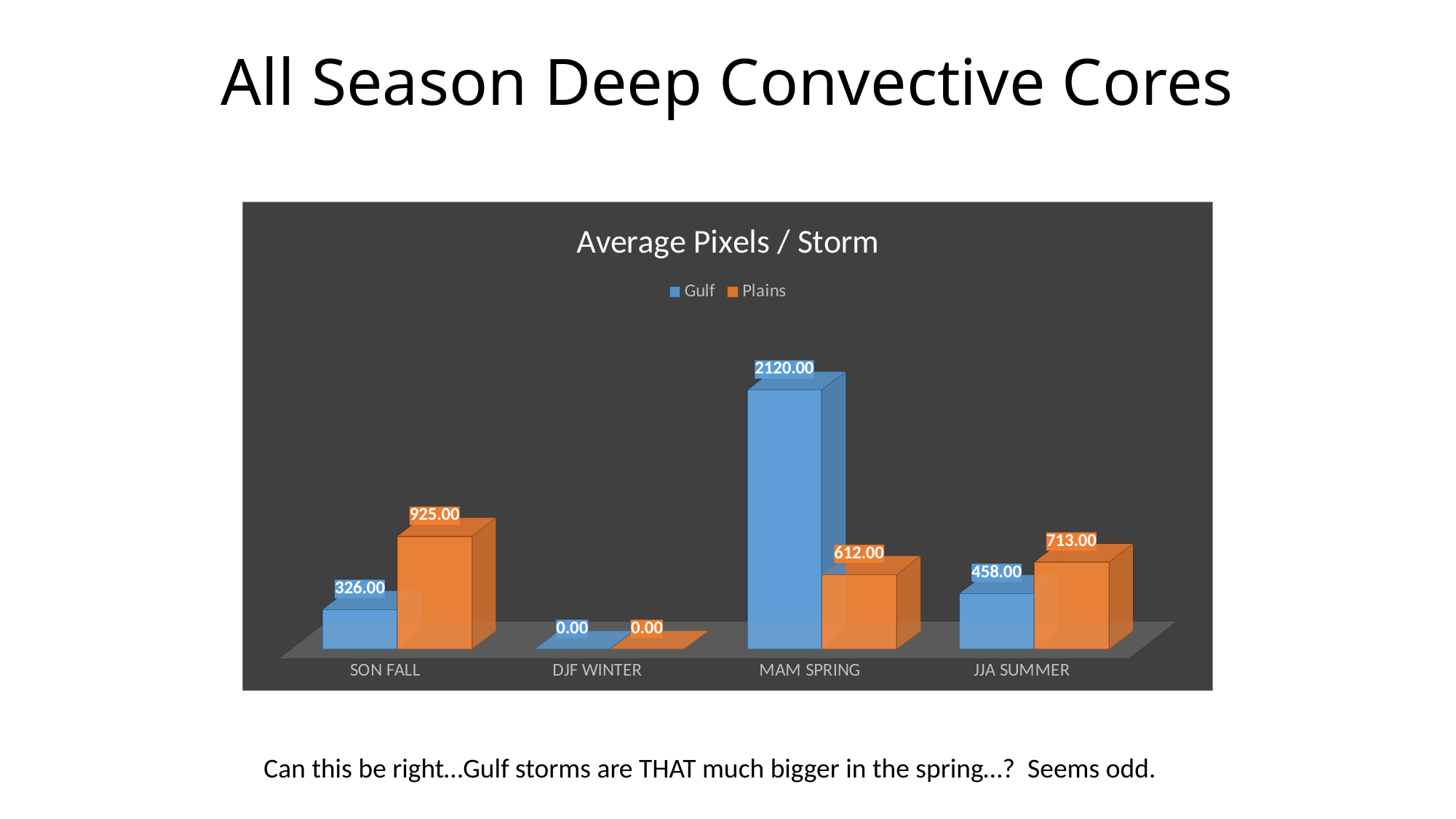
Which is larger for SON FALL, the Gulf value or the Plains value? Plains What is the Gulf value for MAM SPRING? 2120.00 How many seasons are shown on the x axis? 4 What is the Gulf value for JJA SUMMER? 458.00 What is the difference between the Gulf and Plains values for MAM SPRING? 1508.00 Which season has the lowest Plains value? DJF WINTER Which season has the highest Gulf value? MAM SPRING What kind of chart is shown? Bar chart How many series does the legend list? 2 What is the title of the chart? Average Pixels / Storm What is the Plains value for SON FALL? 925.00 What is the Plains value for MAM SPRING? 612.00